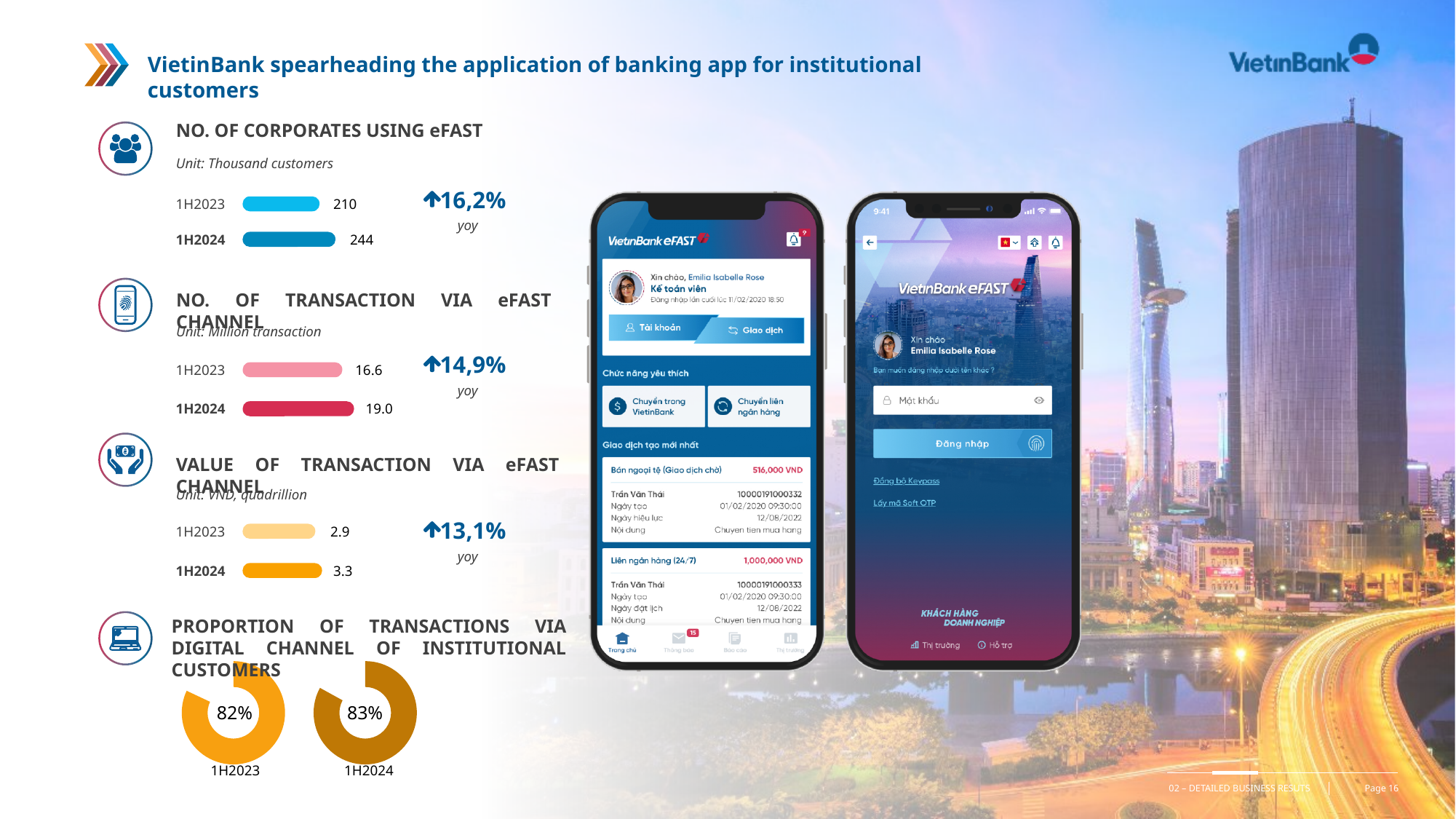
In the 'NO. OF CORPORATES USING eFAST' chart, what is the value for 1H2024? 244 In the 'NO. OF CORPORATES USING eFAST' chart, what is the difference between the 1H2024 and 1H2023 values? 34 In the 'NO. OF TRANSACTION VIA eFAST CHANNEL' chart, what is the value for 1H2023? 16.6 In the 'VALUE OF TRANSACTION VIA eFAST CHANNEL' chart, what is the value for 1H2024? 3.3 In the 'VALUE OF TRANSACTION VIA eFAST CHANNEL' chart, what is the difference between the 1H2024 and 1H2023 values? 0.4 In the 'PROPORTION OF TRANSACTIONS VIA DIGITAL CHANNEL OF INSTITUTIONAL CUSTOMERS' donut charts, what is the share shown for 1H2023? 82% What type of chart is used for 'NO. OF CORPORATES USING eFAST'? Bar chart In the 'NO. OF TRANSACTION VIA eFAST CHANNEL' chart, which period has the higher value? 1H2024 In the 'NO. OF TRANSACTION VIA eFAST CHANNEL' chart, what year-on-year growth rate is shown? 14,9% In the 'PROPORTION OF TRANSACTIONS VIA DIGITAL CHANNEL OF INSTITUTIONAL CUSTOMERS' donut charts, what is the share shown for 1H2024? 83% In the 'NO. OF CORPORATES USING eFAST' chart, what is the value for 1H2023? 210 In the 'VALUE OF TRANSACTION VIA eFAST CHANNEL' chart, what unit is stated for the values? VND, quadrillion